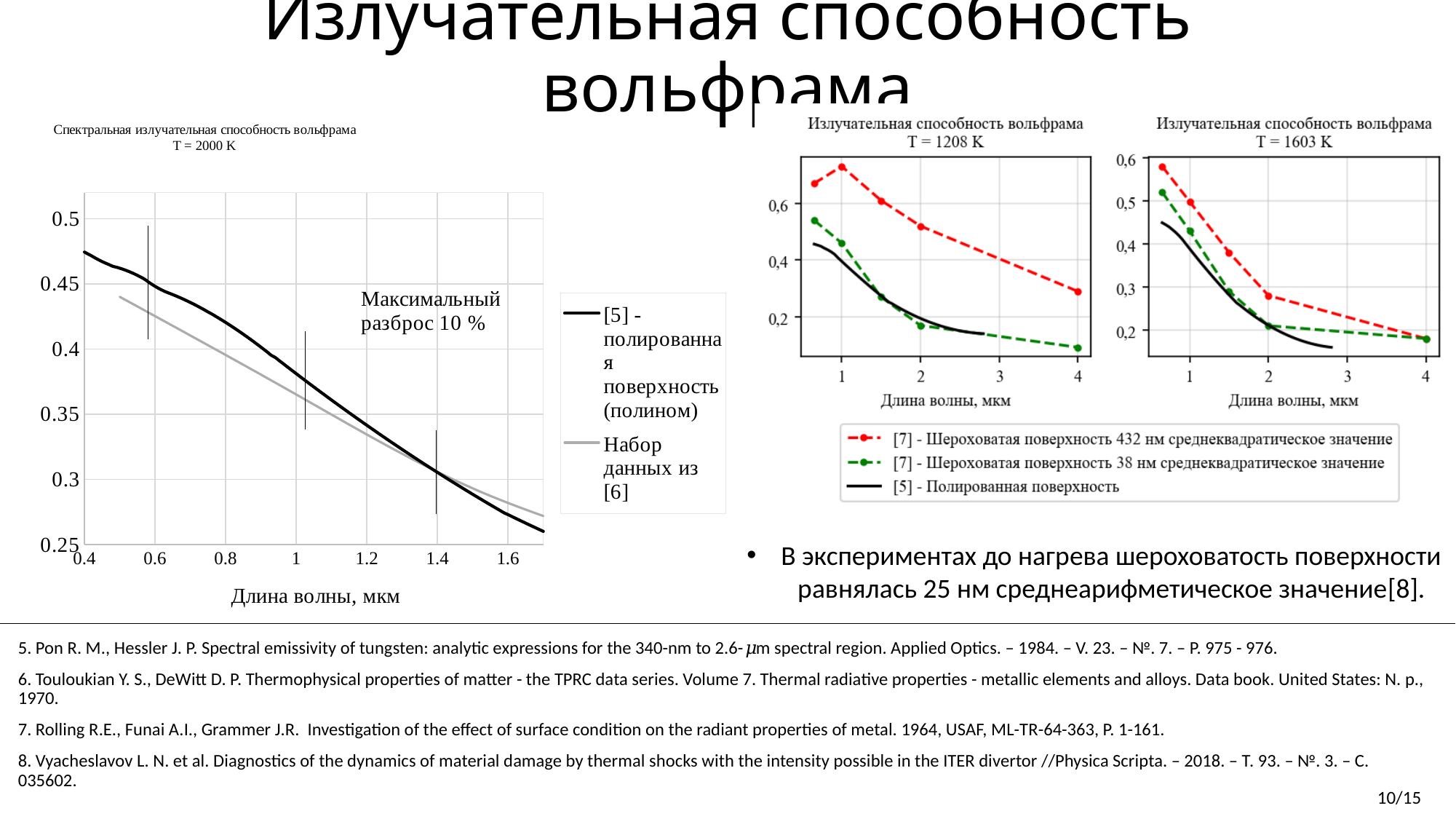
What kind of chart is the left chart titled 'Спектральная излучательная способность вольфрама T = 2000 K'? line chart In the chart titled 'Излучательная способность вольфрама T = 1603 K', is the value of the '[7] - Шероховатая поверхность 432 нм' series at 2 мкм greater or less than 0.3? less In the chart titled 'Излучательная способность вольфрама T = 1603 K', do the values of the '[5] - Полированная поверхность' series rise or fall as wavelength increases? fall In the chart titled 'Излучательная способность вольфрама T = 1208 K', is the value of the '[7] - Шероховатая поверхность 432 нм' series at 1 мкм greater or less than 0.6? greater In the left chart (T = 2000 K), is the value of the '[5] - полированная поверхность (полином)' series at 1.6 мкм greater or less than 0.3? less In the left chart (T = 2000 K), do the values of the '[5] - полированная поверхность (полином)' series rise or fall as wavelength increases? fall In the left chart (T = 2000 K), at 0.6 мкм, which series has the higher value: '[5] - полированная поверхность (полином)' or 'Набор данных из [6]'? [5] - полированная поверхность (полином) In the left chart (T = 2000 K), what maximum spread is stated in the annotation on the plot? 10 % In the chart titled 'Излучательная способность вольфрама T = 1208 K', which series has the highest values across the wavelength range? [7] - Шероховатая поверхность 432 нм среднеквадратическое значение In the chart titled 'Излучательная способность вольфрама T = 1208 K', how many series does the legend list? 3 In the left chart (T = 2000 K), how many series does the legend list? 2